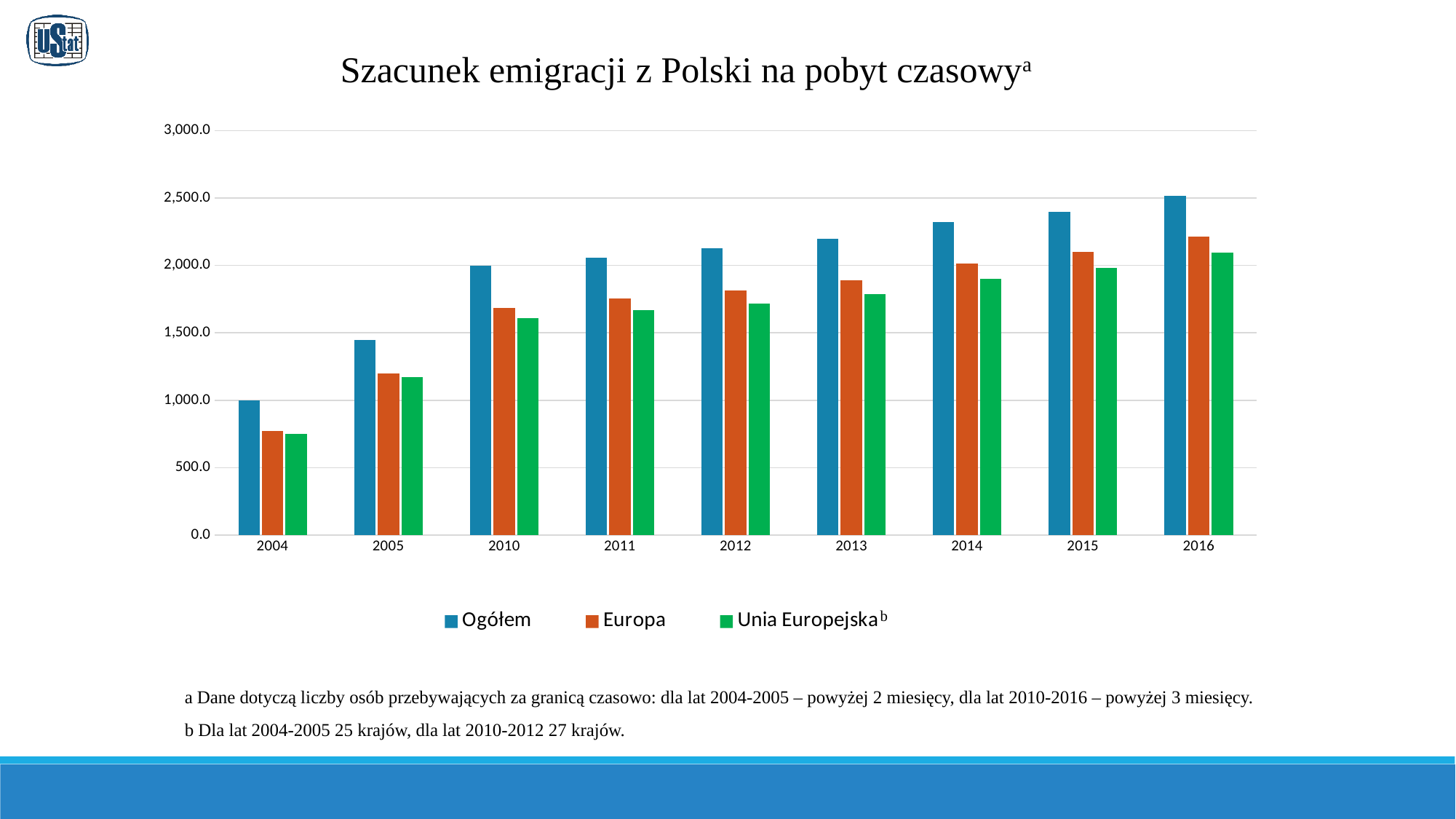
In 2016, which is larger: the Europa value or the Unia Europejska value? Europa How many years are shown on the x axis of the chart? 9 In which year is the Ogółem value lowest? 2004 Do the Ogółem values rise or fall from 2004 to 2016? rise How many series does the legend list? 3 In which year is the Ogółem value highest? 2016 Which is larger: the Ogółem value for 2005 or for 2010? 2010 What colour are the Ogółem bars in the chart? blue Is the Europa value for 2004 greater or less than 1,000.0? less What kind of chart is shown on the slide? bar chart Is the Ogółem value for 2013 greater or less than 2,000.0? greater Is the Ogółem value for 2015 greater or less than 2,500.0? less